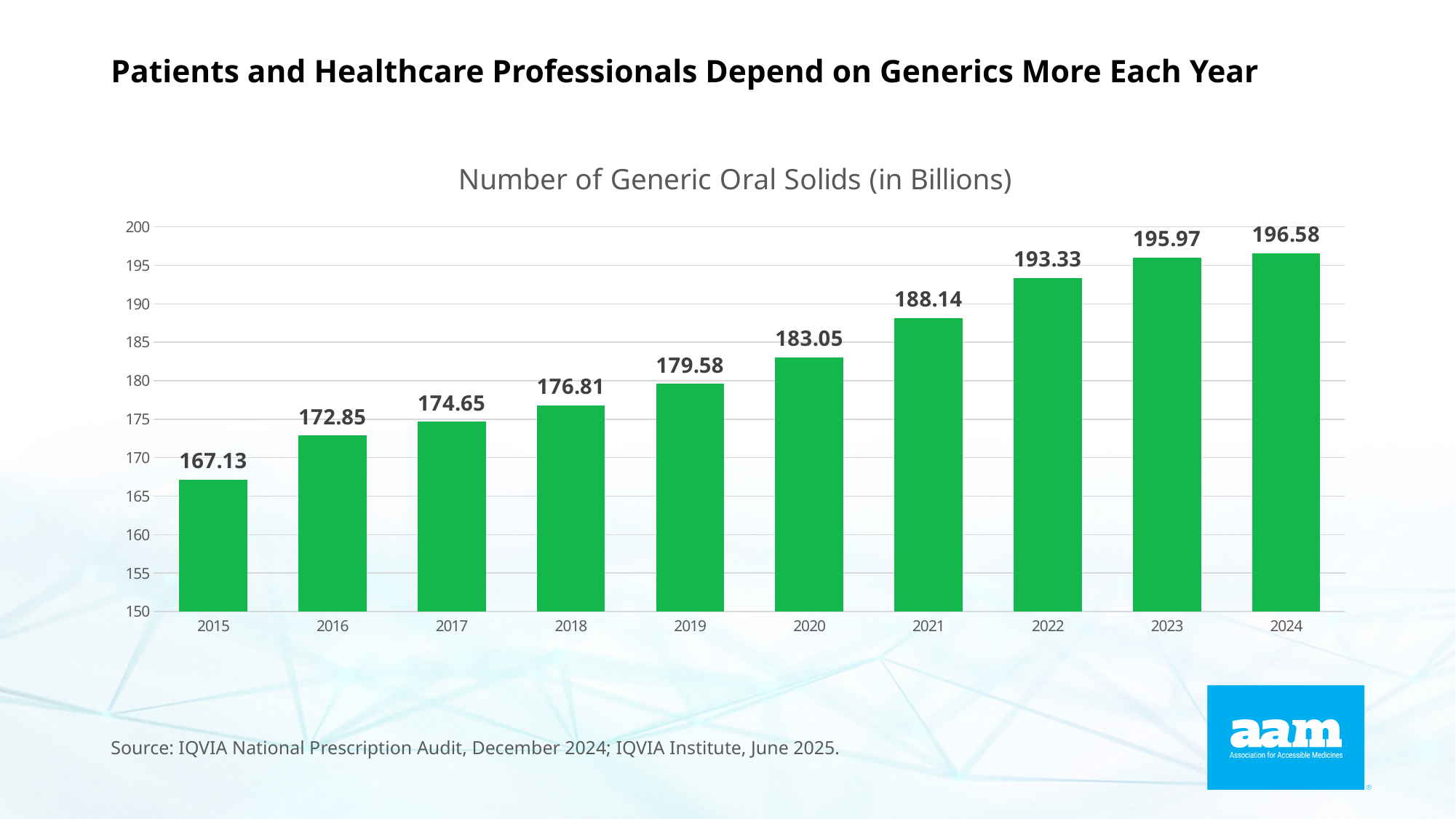
Do the values rise or fall from 2015 to 2024? Rise What is the number of generic oral solids (in billions) for 2020? 183.05 What is the number of generic oral solids (in billions) for 2015? 167.13 What is the number of generic oral solids (in billions) for 2024? 196.58 Is the value for 2021 greater or less than 185? greater What is the difference between the 2024 value and the 2015 value? 29.45 How many years are shown on the chart? 10 Which year has the highest number of generic oral solids? 2024 What kind of chart is shown on the slide? Bar chart Which year has the lowest number of generic oral solids? 2015 What is the difference between the 2022 value and the 2021 value? 5.19 Which year has a larger value, 2018 or 2019? 2019